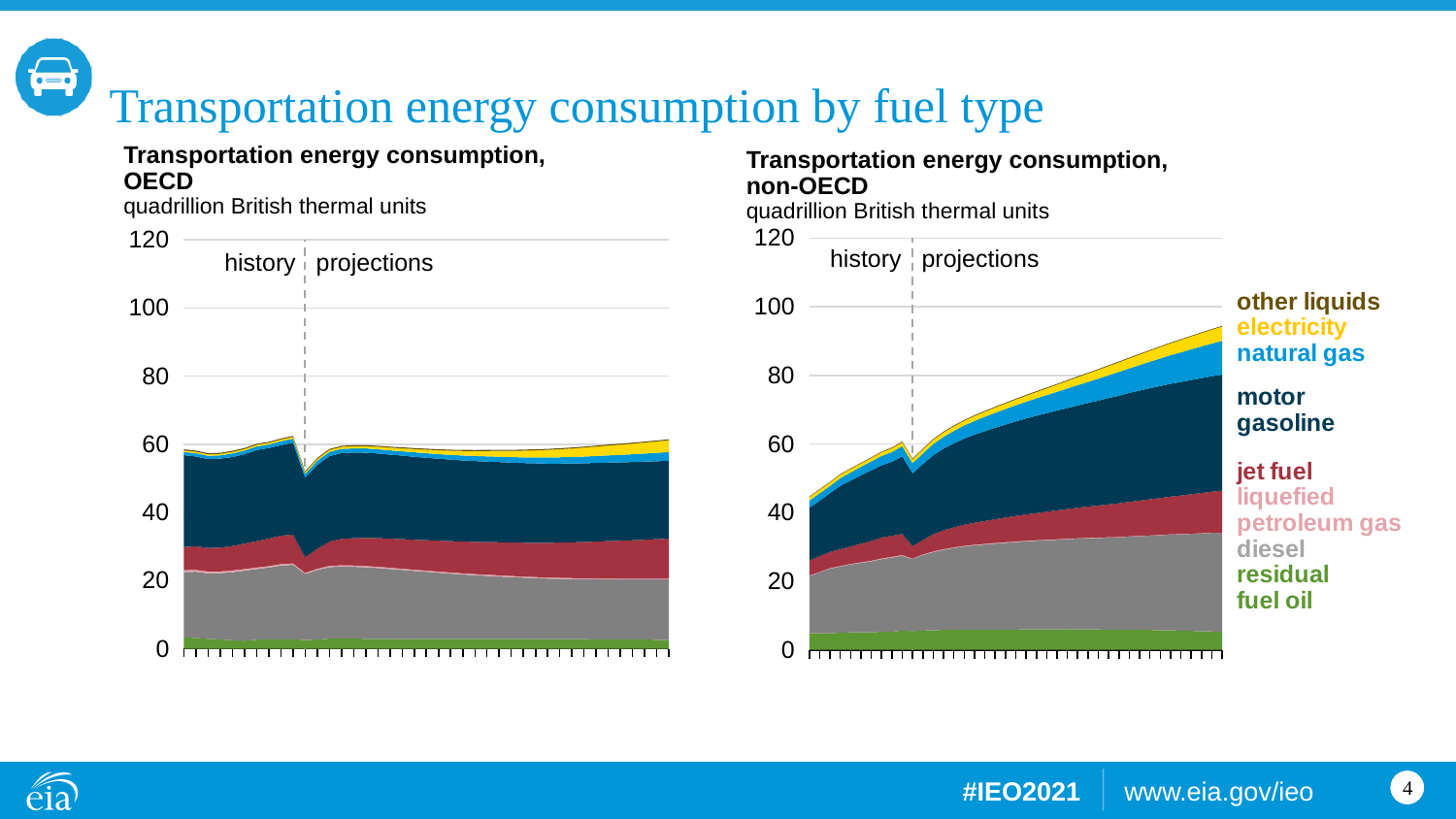
In the 'Transportation energy consumption, OECD' chart, is the total consumption at the end of the projections greater or less than 40? greater In the 'Transportation energy consumption, non-OECD' chart, is the total consumption at the end of the projections greater or less than 100? less In the 'Transportation energy consumption, non-OECD' chart, does total consumption rise or fall over the projection period? rise In the 'Transportation energy consumption, non-OECD' chart, which fuel type accounts for the largest share of consumption at the end of the projections? motor gasoline What kind of chart is the 'Transportation energy consumption, OECD' chart? stacked area chart At the end of the projection period, which region has the larger total transportation energy consumption, OECD or non-OECD? non-OECD In the 'Transportation energy consumption, OECD' chart, is the total consumption at the end of the projections greater or less than 80? less What unit is used on the y axis of both charts? quadrillion British thermal units What is the highest value shown on the y axis of the 'Transportation energy consumption, OECD' chart? 120 How many fuel types does the legend list for the charts? 8